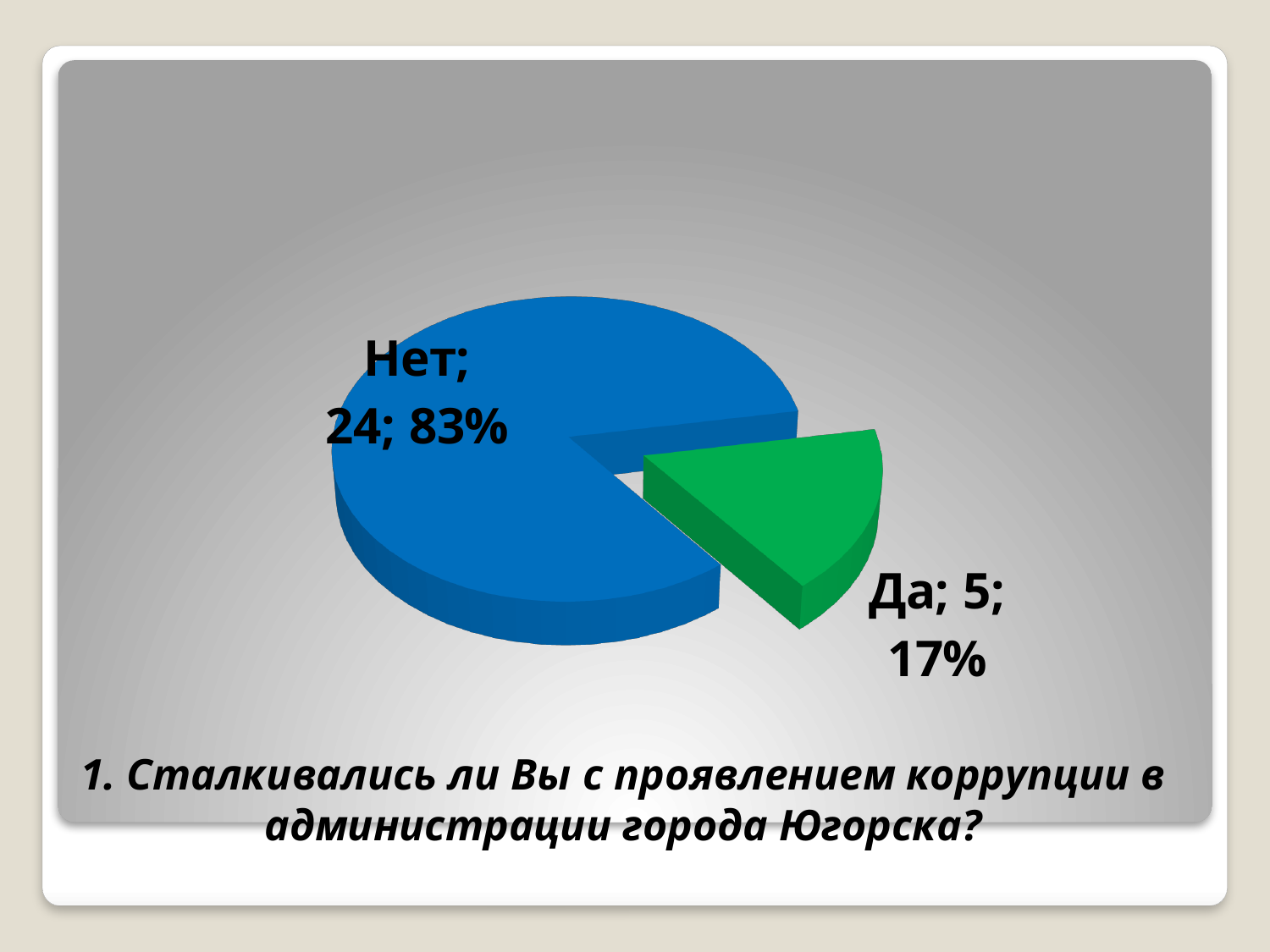
What share of the pie does the "Нет" slice represent? 83% What is the value for the "Нет" slice? 24 What kind of chart is shown on the slide? pie chart What is the total of the two slice values? 29 What colour is the "Да" slice? green What is the difference between the values for "Нет" and "Да"? 19 Which slice is the smallest? Да How many slices does the pie chart have? 2 Which is larger, the value for "Да" or the value for "Нет"? Нет What is the value for the "Да" slice? 5 Which slice is the largest? Нет What share of the pie does the "Да" slice represent? 17%